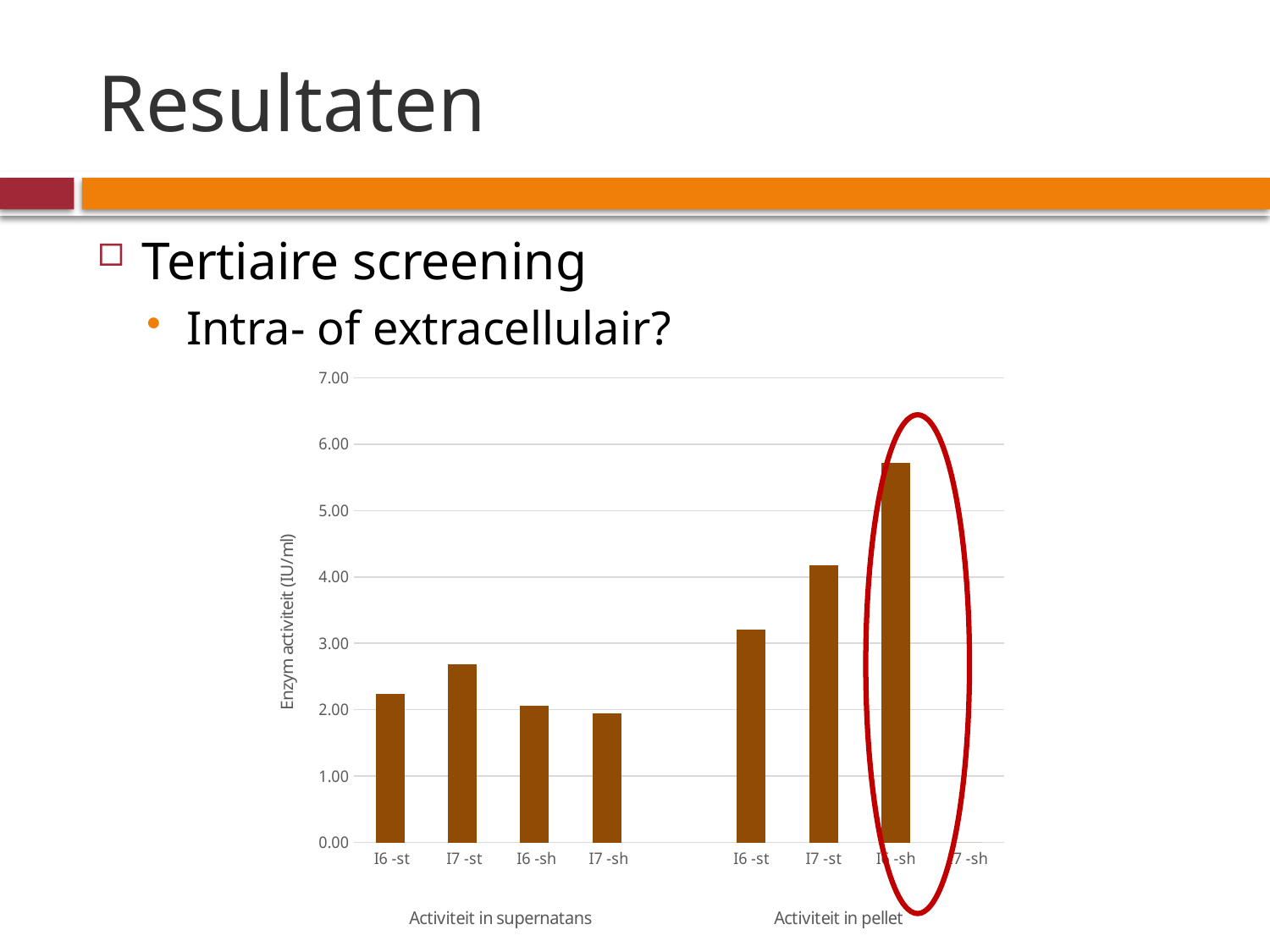
What is the label of the vertical axis? Enzym activiteit (IU/ml) Is the value for I7 -sh in the Activiteit in supernatans group greater or less than 3.00? less Is the value for I7 -st in the Activiteit in pellet group greater or less than 4.00? greater Which is larger: the value for I7 -st in Activiteit in supernatans or the value for I7 -st in Activiteit in pellet? I7 -st in Activiteit in pellet In the Activiteit in pellet group, do the bars rise or fall from I6 -st to I6 -sh? rise How many category labels are in the Activiteit in supernatans group? 4 Which is larger: the value for I6 -st in Activiteit in supernatans or the value for I6 -st in Activiteit in pellet? I6 -st in Activiteit in pellet Is the value for I6 -sh in the Activiteit in pellet group greater or less than 5.00? greater What kind of chart is shown on the slide? bar chart Which bar is the highest in the chart? I6 -sh (Activiteit in pellet)